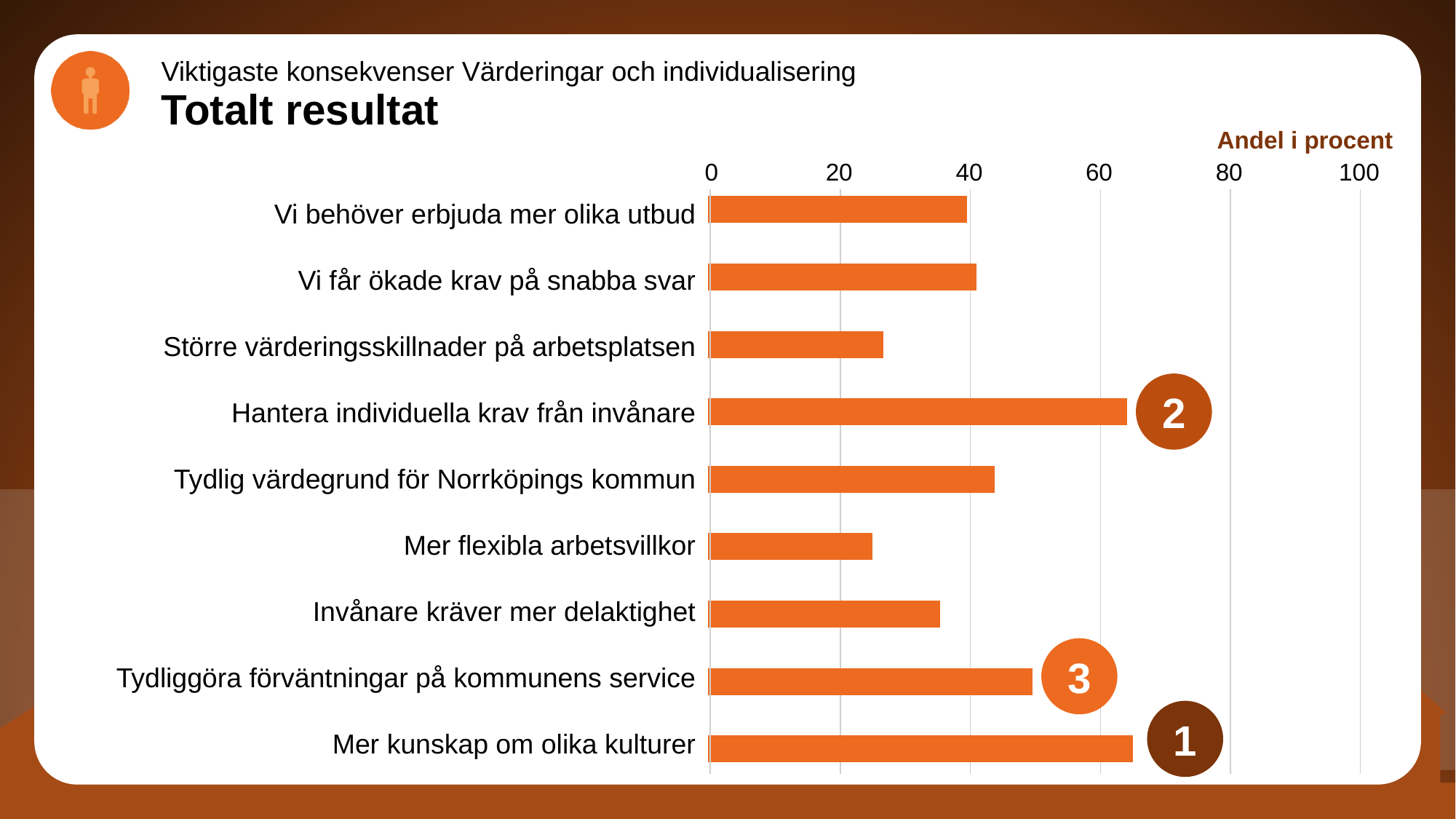
Which category is marked with the circled number 3? Tydliggöra förväntningar på kommunens service Which is larger: the value for "Hantera individuella krav från invånare" or for "Mer flexibla arbetsvillkor"? Hantera individuella krav från invånare Which category has the highest value in the chart? Mer kunskap om olika kulturer What unit label is shown above the chart's value axis? Andel i procent Is the value for "Större värderingsskillnader på arbetsplatsen" greater or less than 20? greater Is the value for "Tydliggöra förväntningar på kommunens service" greater or less than 40? greater Is the value for "Invånare kräver mer delaktighet" greater or less than 40? less What kind of chart is shown on the slide? bar chart How many categories are plotted in the chart? 9 Which is larger: the value for "Tydlig värdegrund för Norrköpings kommun" or for "Invånare kräver mer delaktighet"? Tydlig värdegrund för Norrköpings kommun